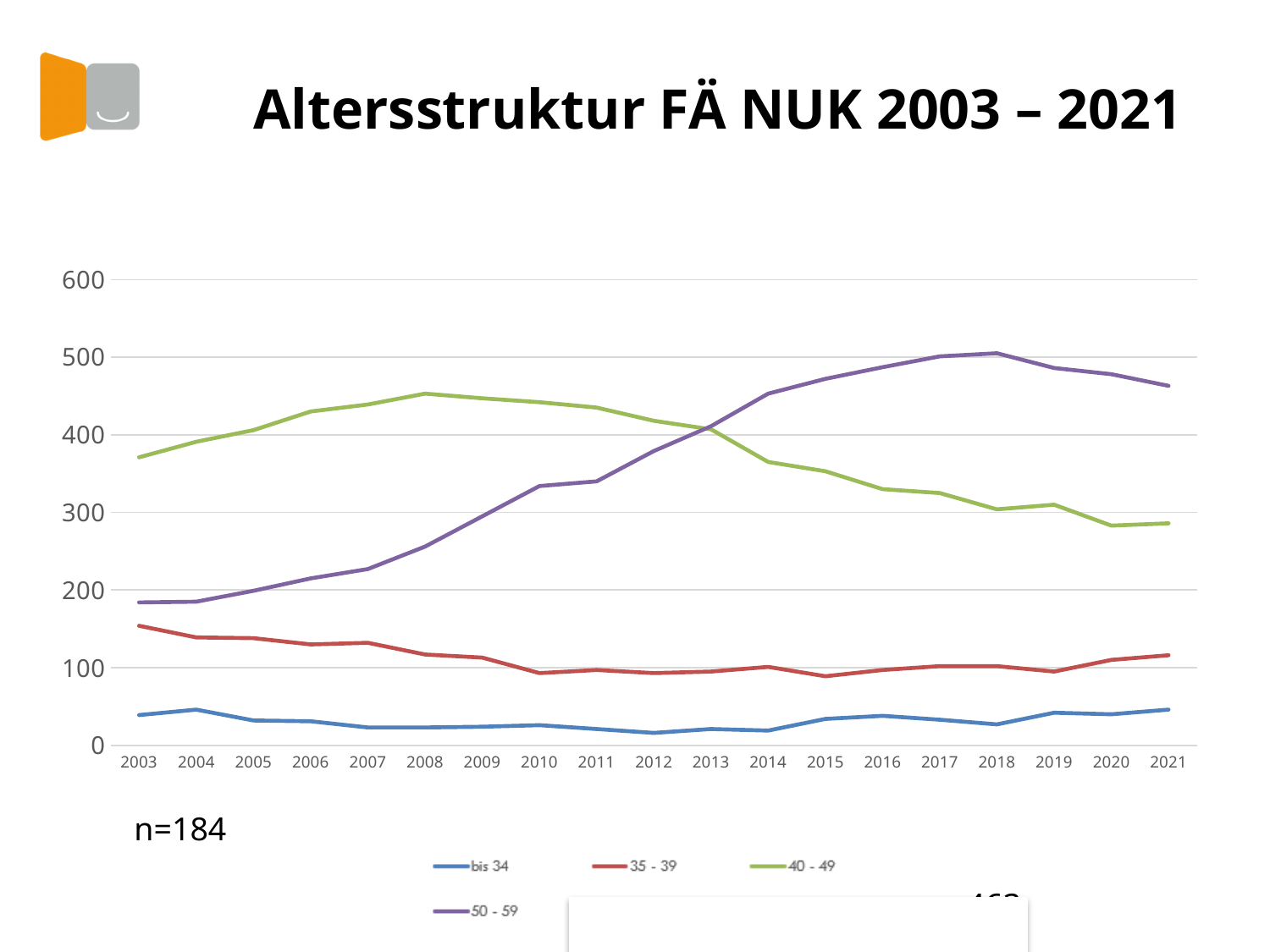
What kind of chart is shown on the slide? line chart Does the 50 - 59 series rise or fall from 2003 to 2018? rise Which series has the lowest values throughout the chart? bis 34 Does the 40 - 49 series rise or fall from 2008 to 2021? fall Is the value for the bis 34 series in 2012 greater or less than 100? less Is the value for the 40 - 49 series in 2008 greater or less than 400? greater Is the value for the 35 - 39 series in 2003 greater or less than 100? greater How many series does the legend list? 4 In 2003, which series has the larger value: 40 - 49 or 50 - 59? 40 - 49 In 2021, which series has the larger value: 50 - 59 or 40 - 49? 50 - 59 How many years are plotted along the x axis? 19